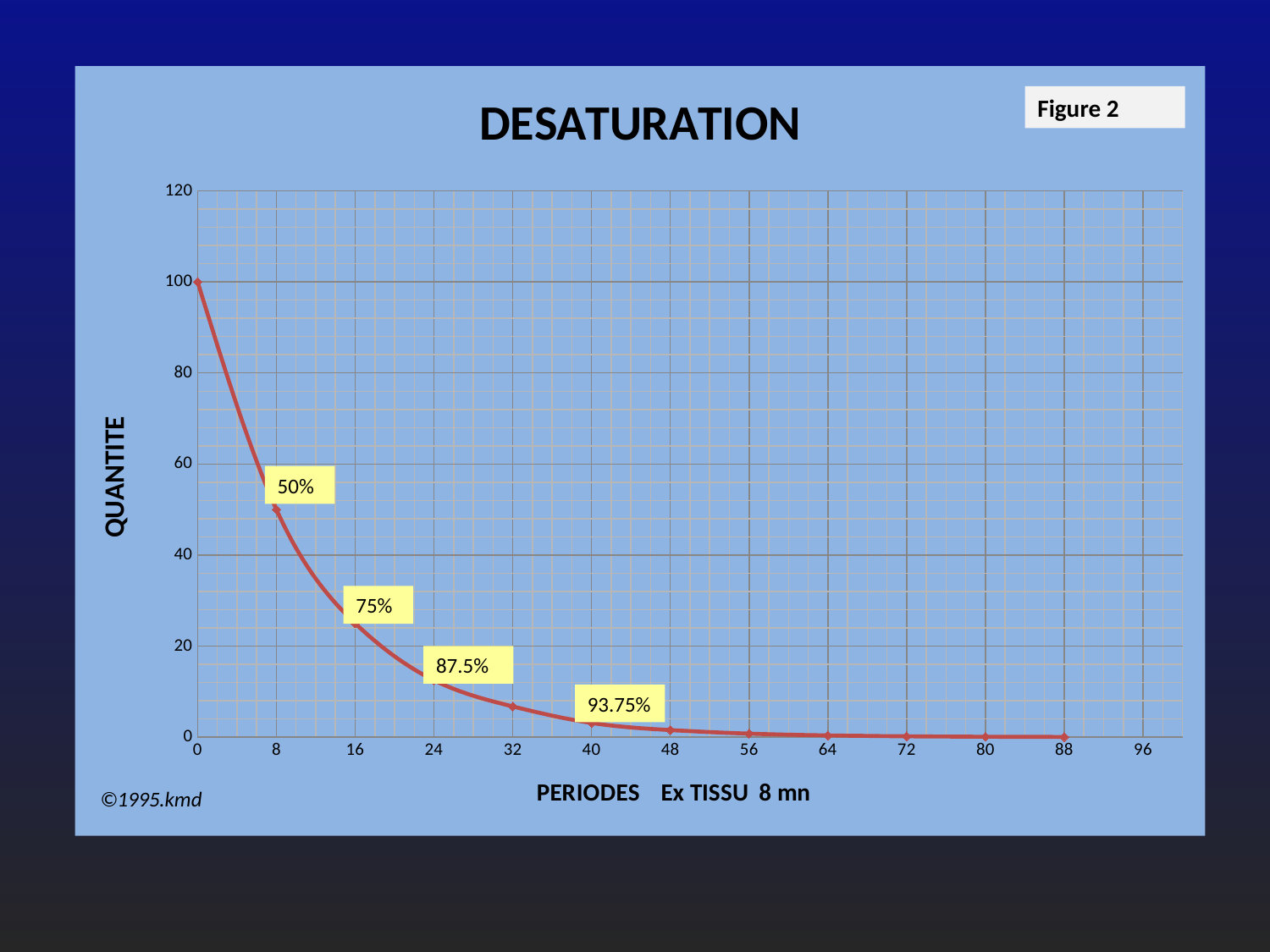
Is the value at period 16 greater or less than 40? less What is the title of the chart? DESATURATION How many data points are plotted on the line? 12 Do the values rise or fall as the periods increase along the x axis? fall What is the value of QUANTITE at period 0? 100 What kind of chart is shown on the slide? line chart Is the value at period 8 greater or less than 60? less Which has the larger value, period 8 or period 16? period 8 Is the value at period 24 greater or less than 20? less At which period is the value highest? 0 What is the label on the y axis? QUANTITE